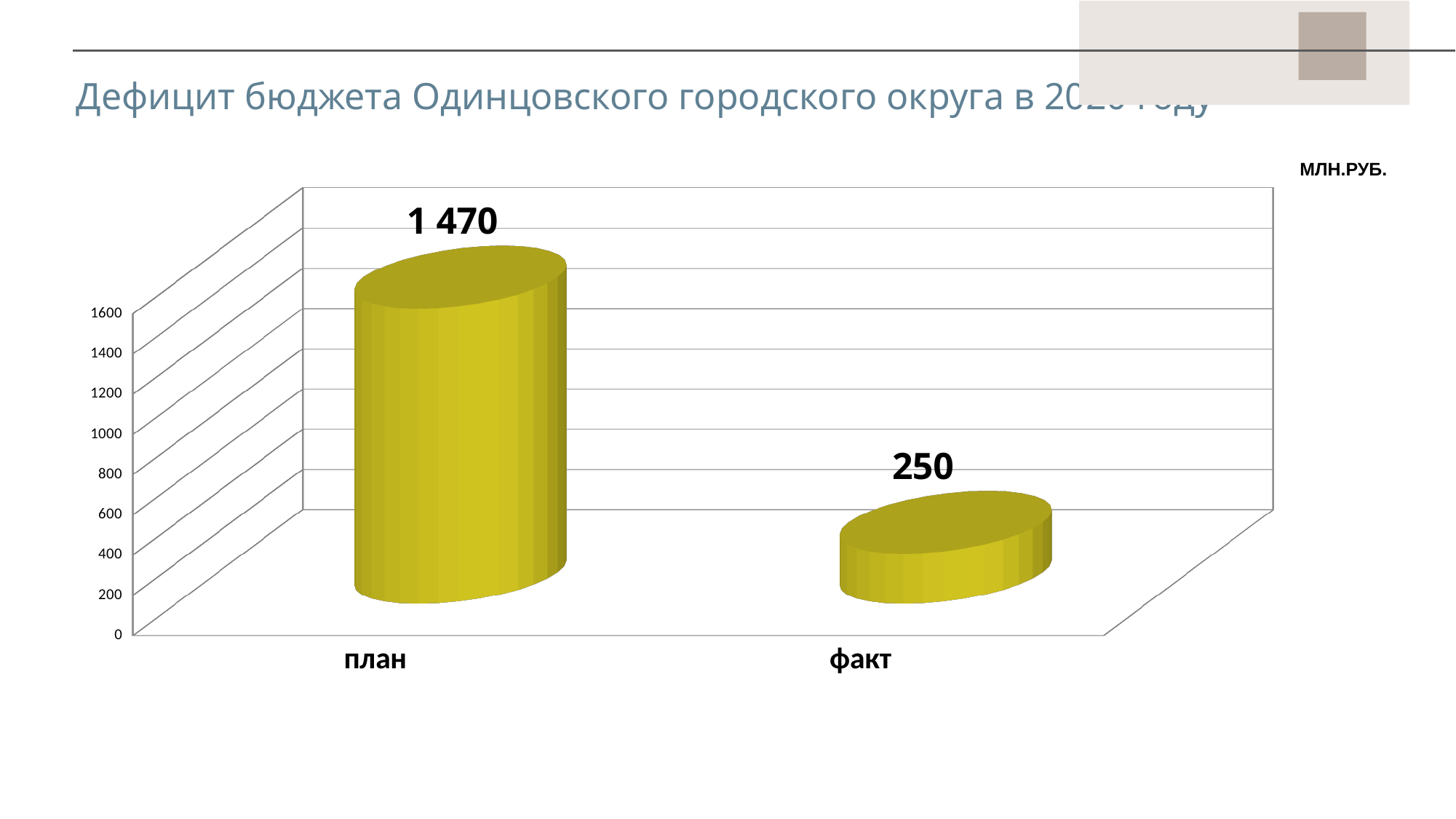
Which is larger, the value for план or the value for факт? план Is the value for план greater or less than 1200? greater How many categories are shown on the chart? 2 What is the difference between the values for план and факт? 1 220 What is the value for план? 1 470 Is the value for факт greater or less than 400? less What is the highest value shown on the vertical axis? 1600 What unit is indicated for the values on the chart? МЛН.РУБ. Which category has the highest value? план Which category has the lowest value? факт What is the value for факт? 250 What kind of chart is shown on the slide? bar chart